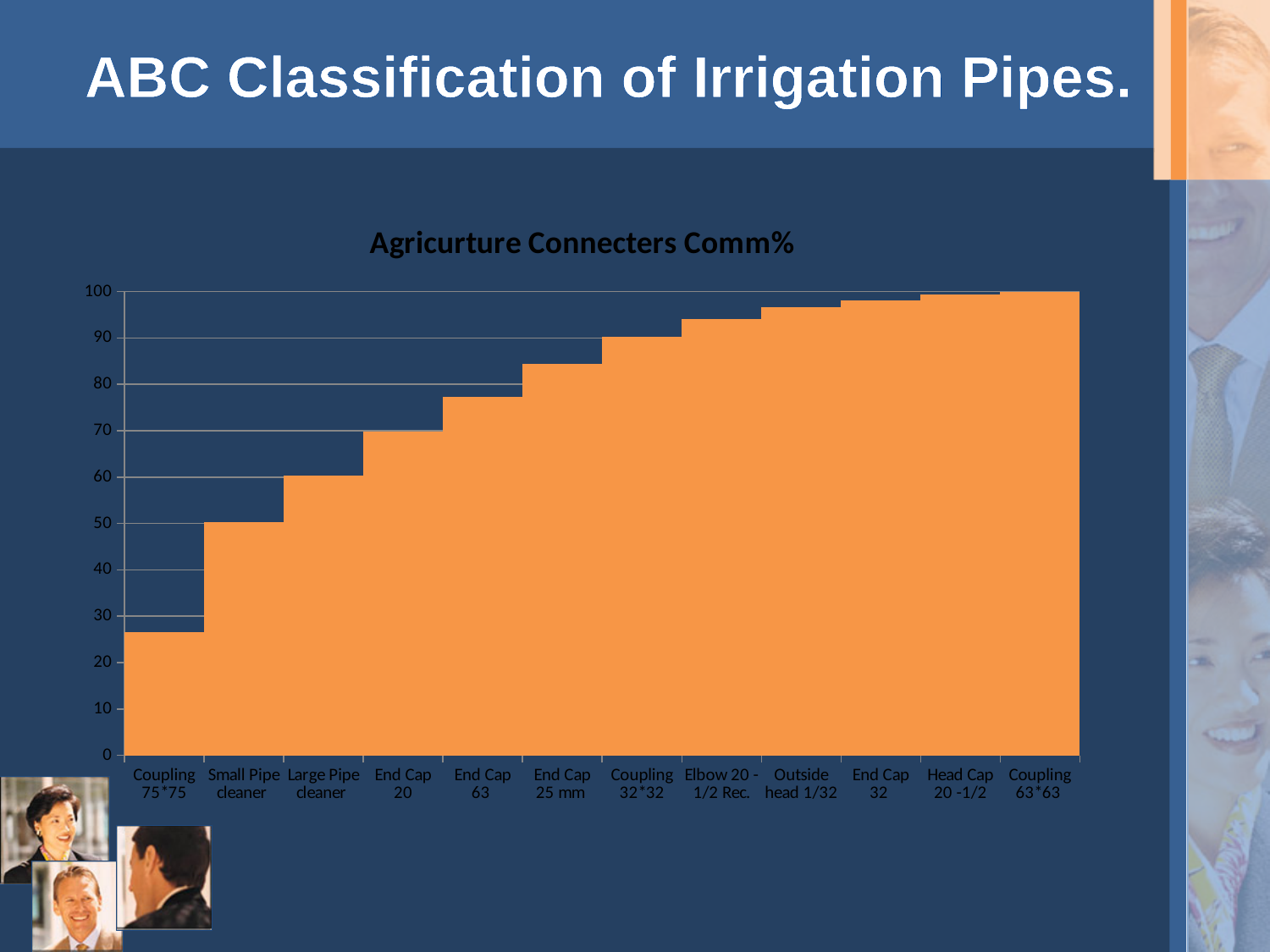
Which category has the lowest value in the chart? Coupling 75*75 What is the title of the chart? Agricurture Connecters Comm% Is the value for Coupling 32*32 greater or less than 80? greater Is the value for Small Pipe cleaner greater or less than 40? greater Is the value for End Cap 20 greater or less than 80? less What kind of chart is shown on the slide? bar chart Do the values rise or fall moving left to right along the x axis? rise Which is larger, the value for Coupling 75*75 or the value for Small Pipe cleaner? Small Pipe cleaner Which is larger, the value for Large Pipe cleaner or the value for End Cap 63? End Cap 63 How many categories are shown on the x axis of the chart? 12